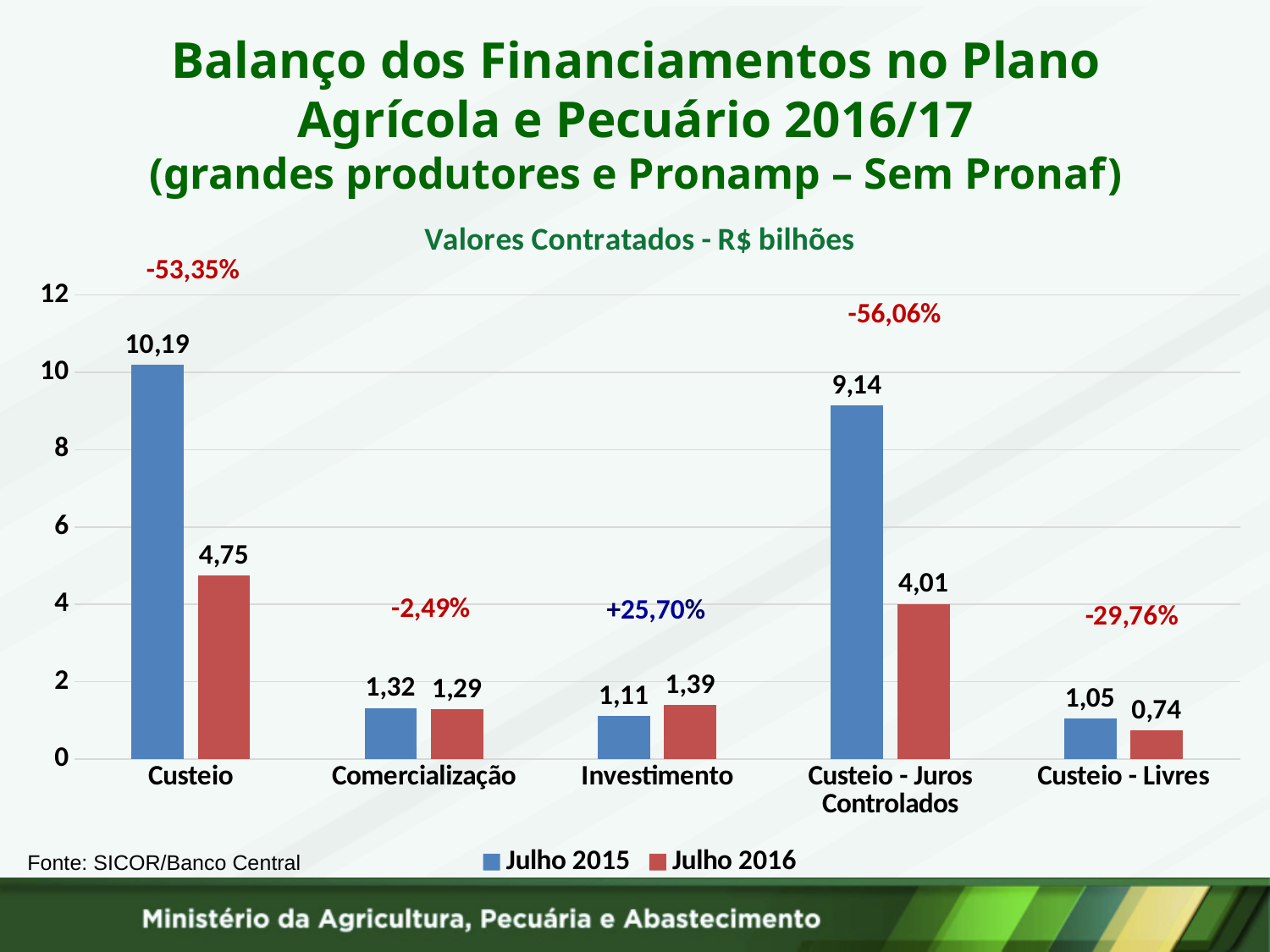
How many categories are shown on the x axis? 5 What is the difference between the Julho 2015 and Julho 2016 values for Custeio? 5,44 What is the value for Custeio - Juros Controlados in Julho 2016? 4,01 How many series does the legend list? 2 What is the title of the chart? Valores Contratados - R$ bilhões What kind of chart is shown on the slide? Bar chart What is the value for Investimento in Julho 2016? 1,39 Which category has the lowest value in Julho 2016? Custeio - Livres What is the value for Custeio in Julho 2015? 10,19 Which category has the highest value in Julho 2015? Custeio Which is larger for Investimento: the Julho 2015 value or the Julho 2016 value? Julho 2016 What percentage change is shown above the Custeio - Juros Controlados bars? -56,06%